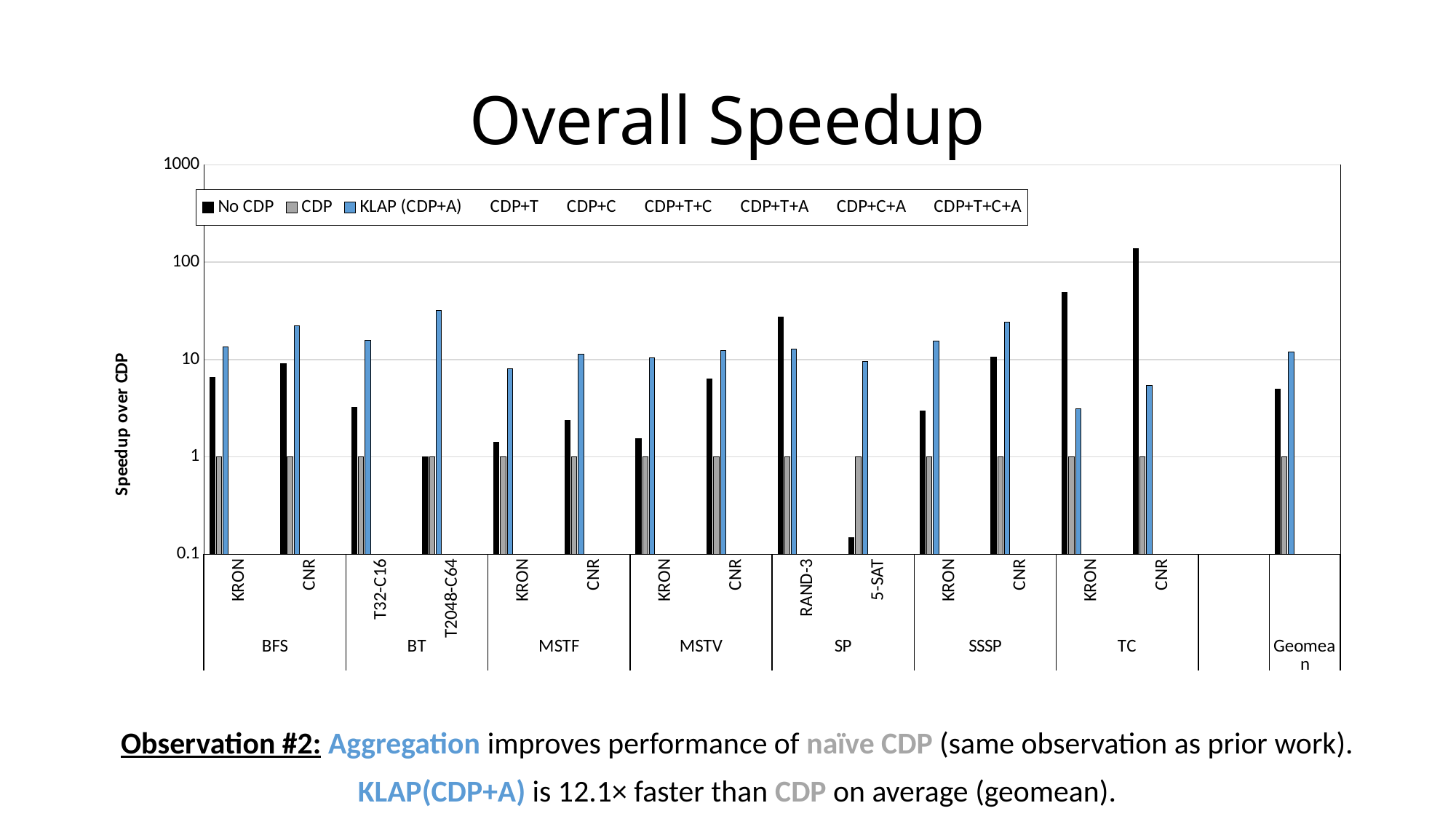
What kind of chart is shown on the slide? bar chart How many series does the legend list? 9 What is the label of the y axis? Speedup over CDP Which category has the highest KLAP (CDP+A) bar? BT T2048-C64 Which category has the highest No CDP bar? TC CNR What is the title of the chart? Overall Speedup For TC KRON, which is larger: No CDP or KLAP (CDP+A)? No CDP What is the CDP value for BFS KRON? 1 Is the KLAP (CDP+A) value for TC CNR greater or less than 10? less Is the No CDP value for TC CNR greater or less than 100? greater Which category has the lowest No CDP bar? SP 5-SAT How many benchmark groups (excluding Geomean) are shown along the x axis? 7